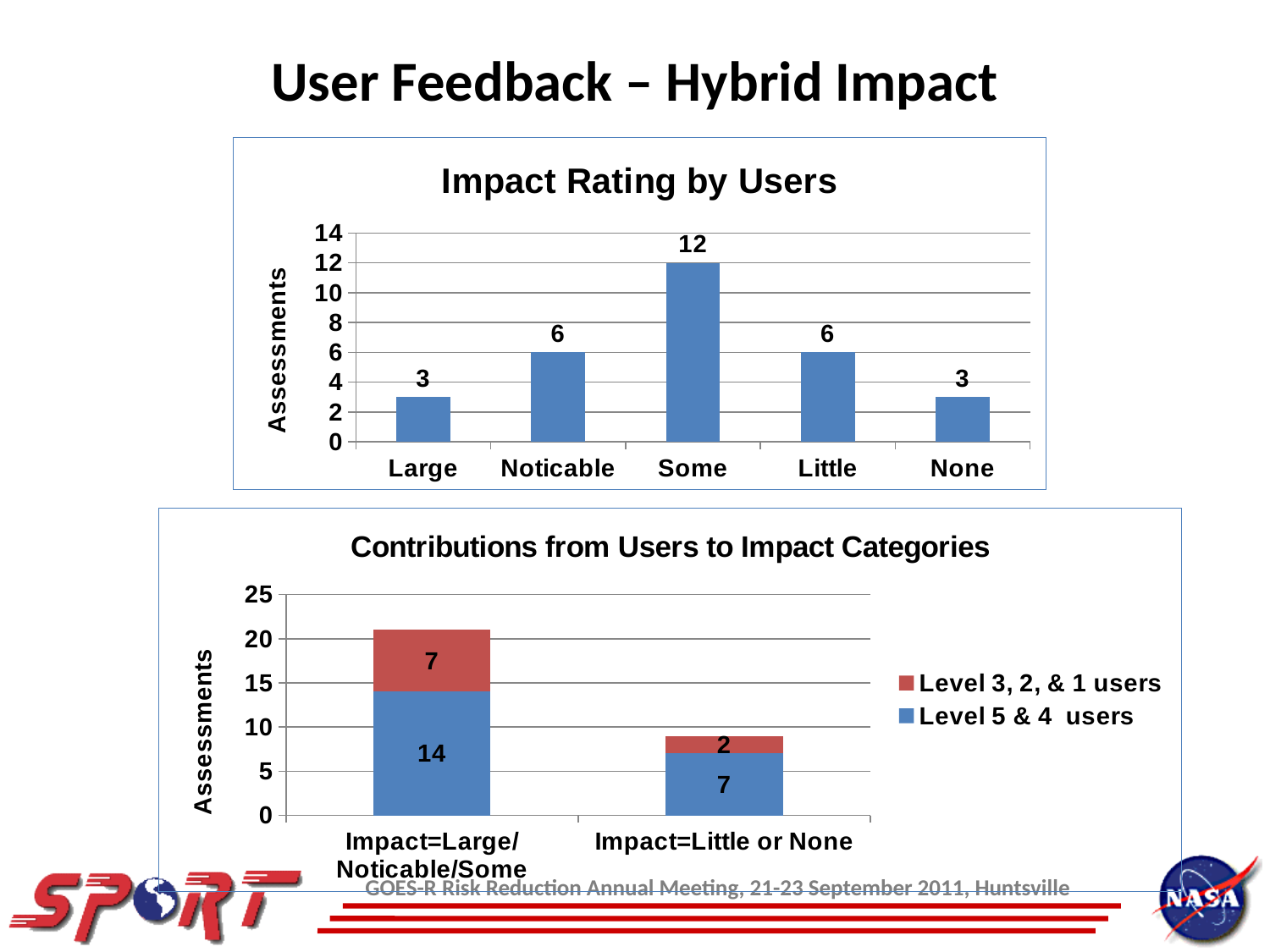
In the 'Contributions from Users to Impact Categories' chart, what is the total of the stacked bar for Impact=Large/Noticable/Some? 21 In the 'Contributions from Users to Impact Categories' chart, what is the value for Level 3, 2, & 1 users in the Impact=Little or None category? 2 In the 'Impact Rating by Users' chart, what kind of chart is it? bar chart In the 'Impact Rating by Users' chart, which category has the highest value? Some In the 'Contributions from Users to Impact Categories' chart, what is the total of the stacked bar for Impact=Little or None? 9 In the 'Impact Rating by Users' chart, what is the difference between the values for Some and Large? 9 In the 'Contributions from Users to Impact Categories' chart, how many series does the legend list? 2 In the 'Contributions from Users to Impact Categories' chart, which series is shown in red? Level 3, 2, & 1 users In the 'Impact Rating by Users' chart, what is the value for Some? 12 In the 'Impact Rating by Users' chart, how many categories are shown on the x axis? 5 In the 'Contributions from Users to Impact Categories' chart, what is the value for Level 5 & 4 users in the Impact=Large/Noticable/Some category? 14 In the 'Impact Rating by Users' chart, what is the value for Noticable? 6